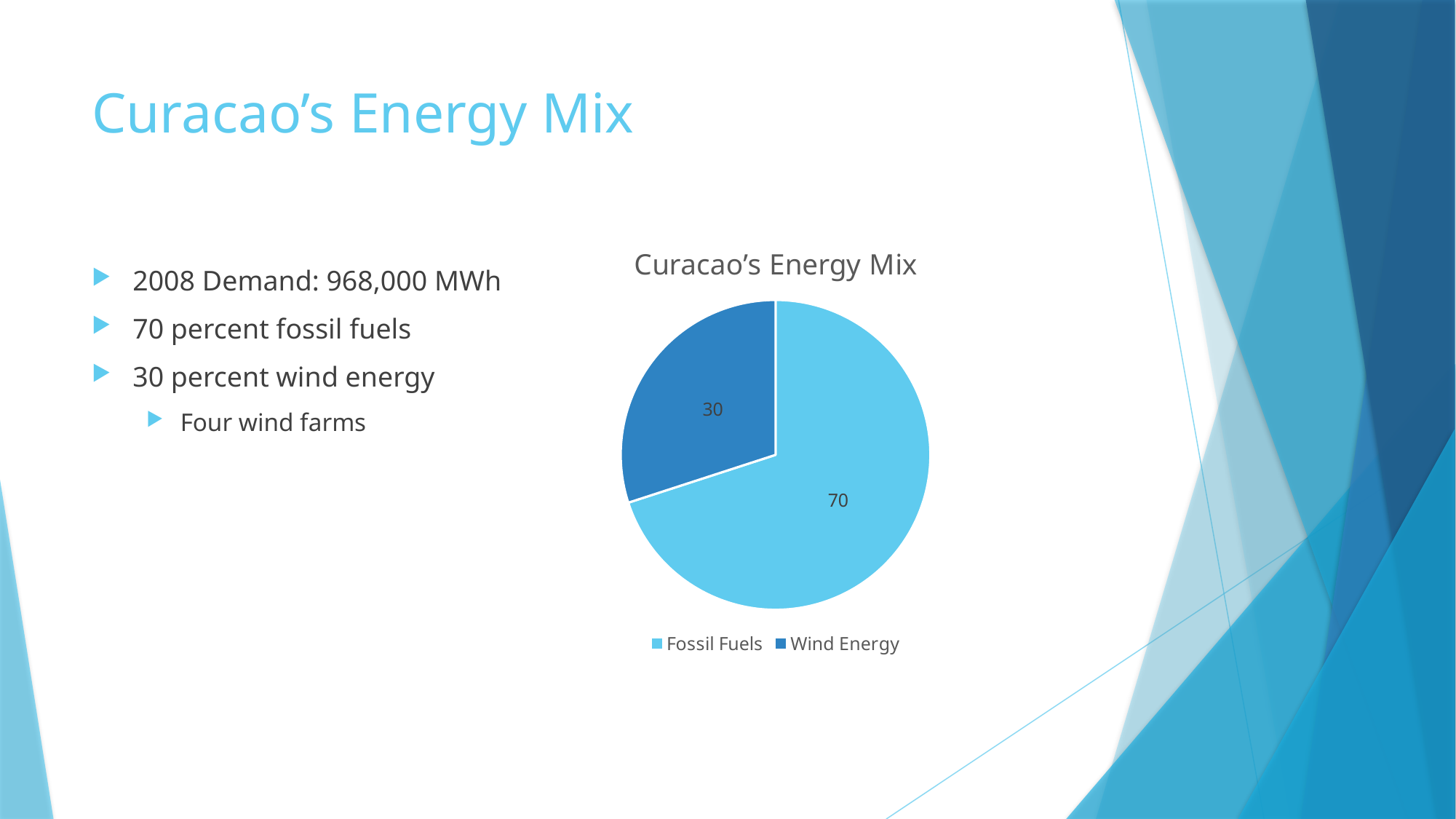
How many slices does the pie chart have? 2 What is the value for Fossil Fuels in the pie chart? 70 Which legend entry is shown in the darker blue colour? Wind Energy How many entries does the legend list? 2 What is the value for Wind Energy in the pie chart? 30 Which is larger, Fossil Fuels or Wind Energy? Fossil Fuels Which slice of the pie chart is the smallest? Wind Energy What is the difference between the Fossil Fuels and Wind Energy values? 40 Which slice of the pie chart is the largest? Fossil Fuels What is the title of the chart? Curacao's Energy Mix What type of chart is shown on the slide? pie chart What share of the pie does Wind Energy represent? 30%